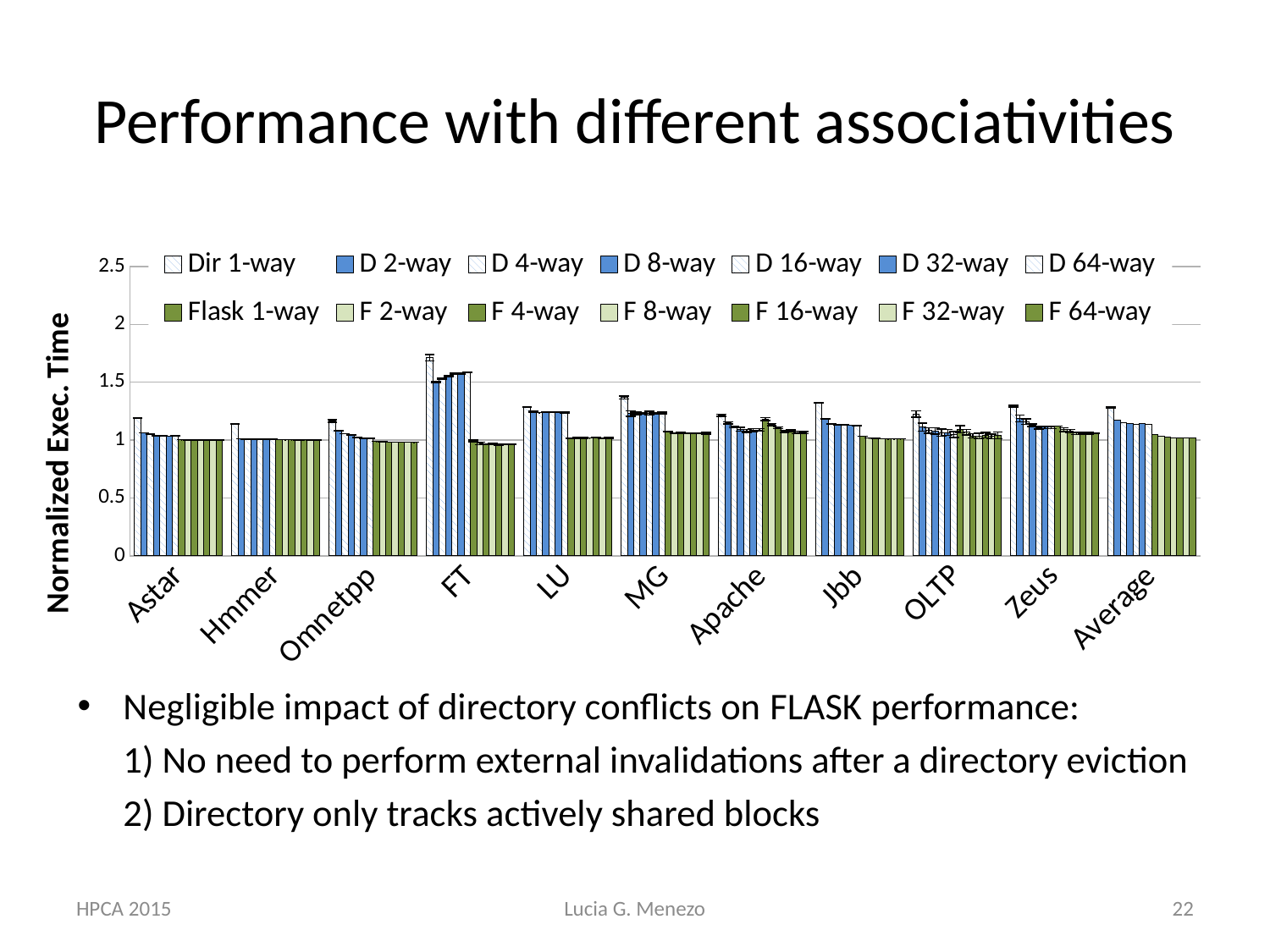
What is the label of the y axis of the chart? Normalized Exec. Time What is the first series listed in the chart's legend? Dir 1-way In FT, which is larger: the Dir 1-way bar or the Flask 1-way bar? Dir 1-way Which is larger: the Dir 1-way bar for FT or the Dir 1-way bar for Hmmer? FT Is the value for Flask 1-way in FT greater or less than 1.5? less How many series does the chart's legend list? 14 Is the value for Dir 1-way in FT greater or less than 1.5? greater How many categories are shown along the x axis of the chart? 11 Which category has the highest Dir 1-way bar? FT Is the value for Dir 1-way in Astar greater or less than 1.5? less What kind of chart is shown on the slide? bar chart